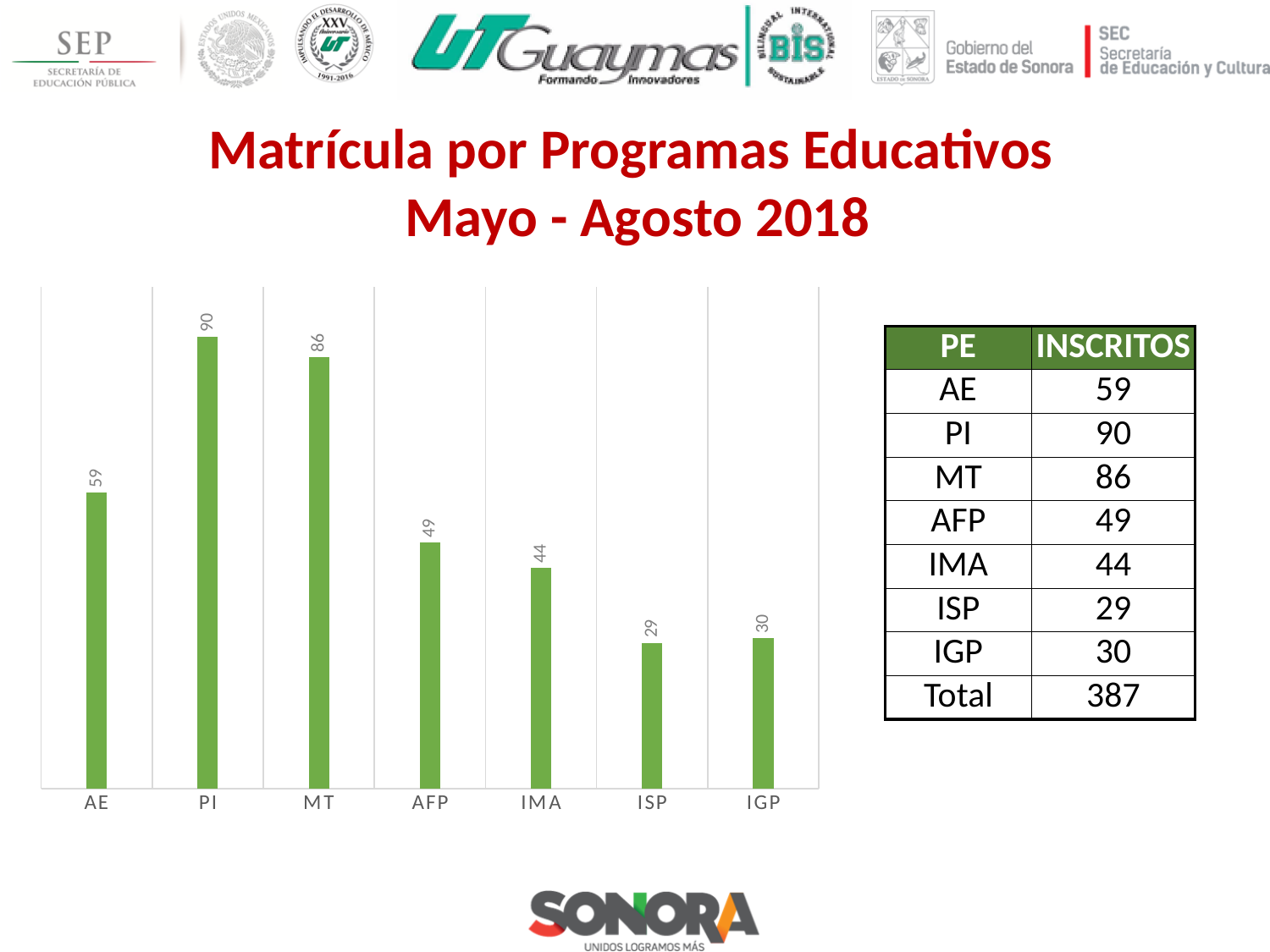
What is the value for PI in the bar chart? 90 How many categories are shown in the bar chart? 7 What colour are the bars in the chart? green Which category has the highest value in the bar chart? PI Which category has the lowest value in the bar chart? ISP What is the difference between the values for AE and IMA? 15 What is the value for AFP in the bar chart? 49 What kind of chart is shown on the slide? bar chart Which is larger, the value for AE or the value for AFP? AE What is the difference between the values for PI and MT? 4 Which is larger, the value for IGP or the value for ISP? IGP What is the value for ISP in the bar chart? 29